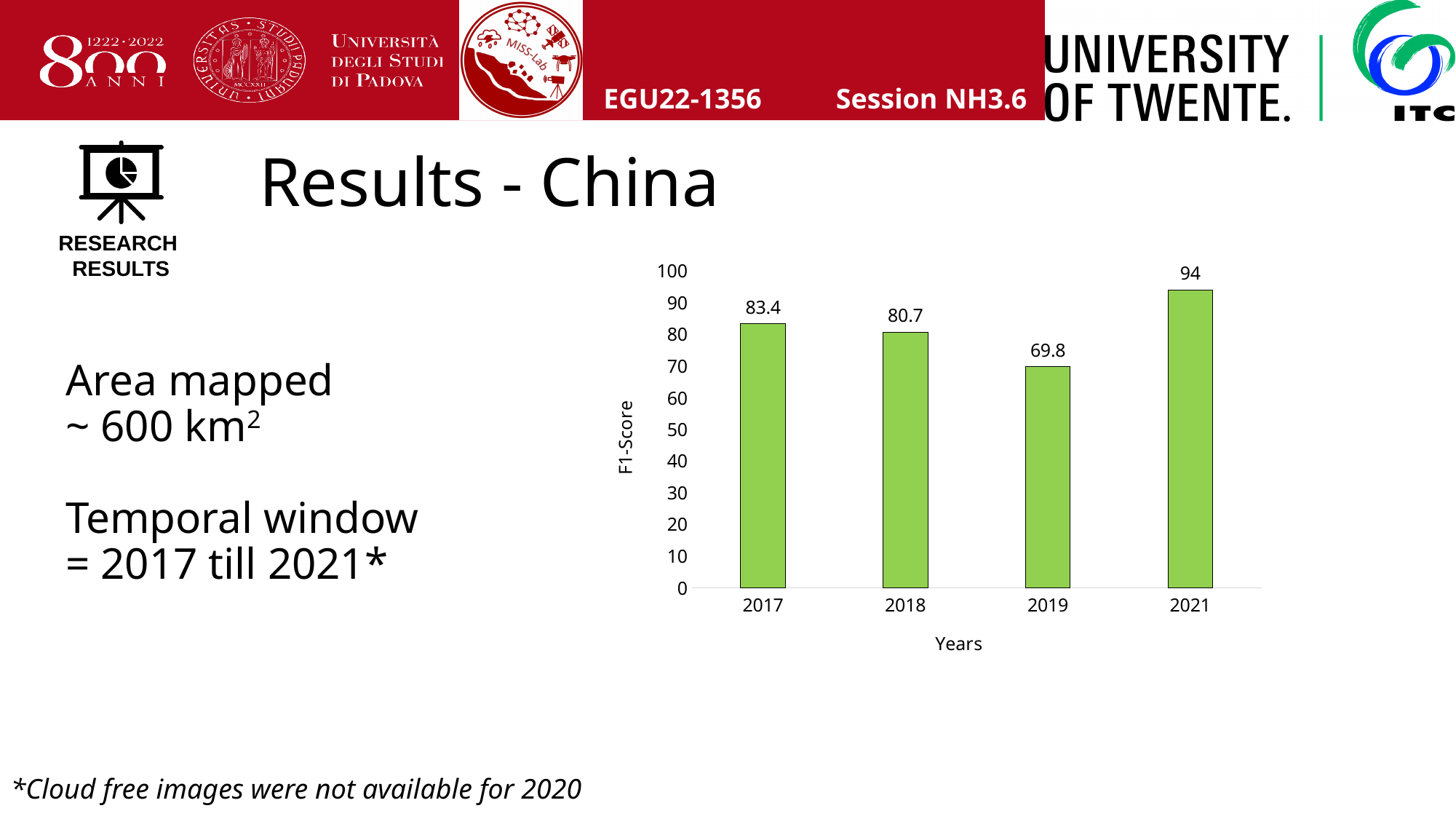
Which year has the lowest F1-Score? 2019 What is the F1-Score for 2019? 69.8 Which year has a higher F1-Score, 2018 or 2019? 2018 What is the F1-Score for 2017? 83.4 What is the F1-Score for 2021? 94 What is the label of the vertical axis of the chart? F1-Score How many years are shown on the x axis of the chart? 4 What is the difference between the F1-Score for 2017 and the F1-Score for 2018? 2.7 What kind of chart is shown on the slide? bar chart Which year has the highest F1-Score? 2021 Is the F1-Score for 2021 greater or less than 90? greater What is the difference between the F1-Score for 2021 and the F1-Score for 2019? 24.2